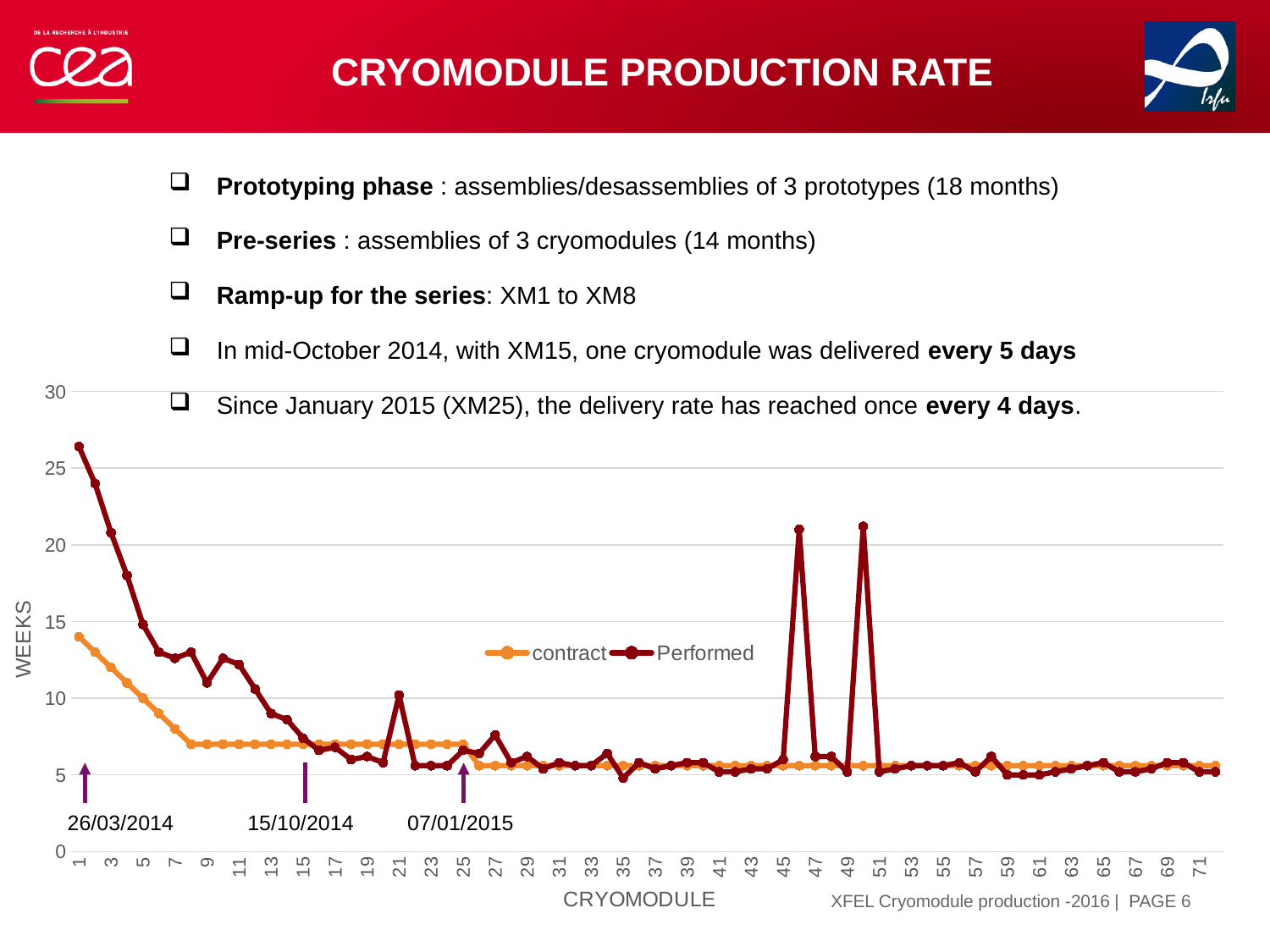
At which cryomodule does the Performed series reach its highest value? 1 What are the two series named in the chart legend? contract and Performed Does the contract series rise or fall from cryomodule 1 to cryomodule 9? fall At cryomodule 1, which series has the higher value, contract or Performed? Performed What is the label of the chart's vertical axis? WEEKS Is the Performed value for cryomodule 1 greater or less than 25? greater What is the highest cryomodule number labelled on the x axis? 71 How many series does the chart legend list? 2 Is the Performed value for cryomodule 47 greater or less than 15? less Is the Performed value for cryomodule 71 greater or less than 10? less What kind of chart is shown on the slide? line chart